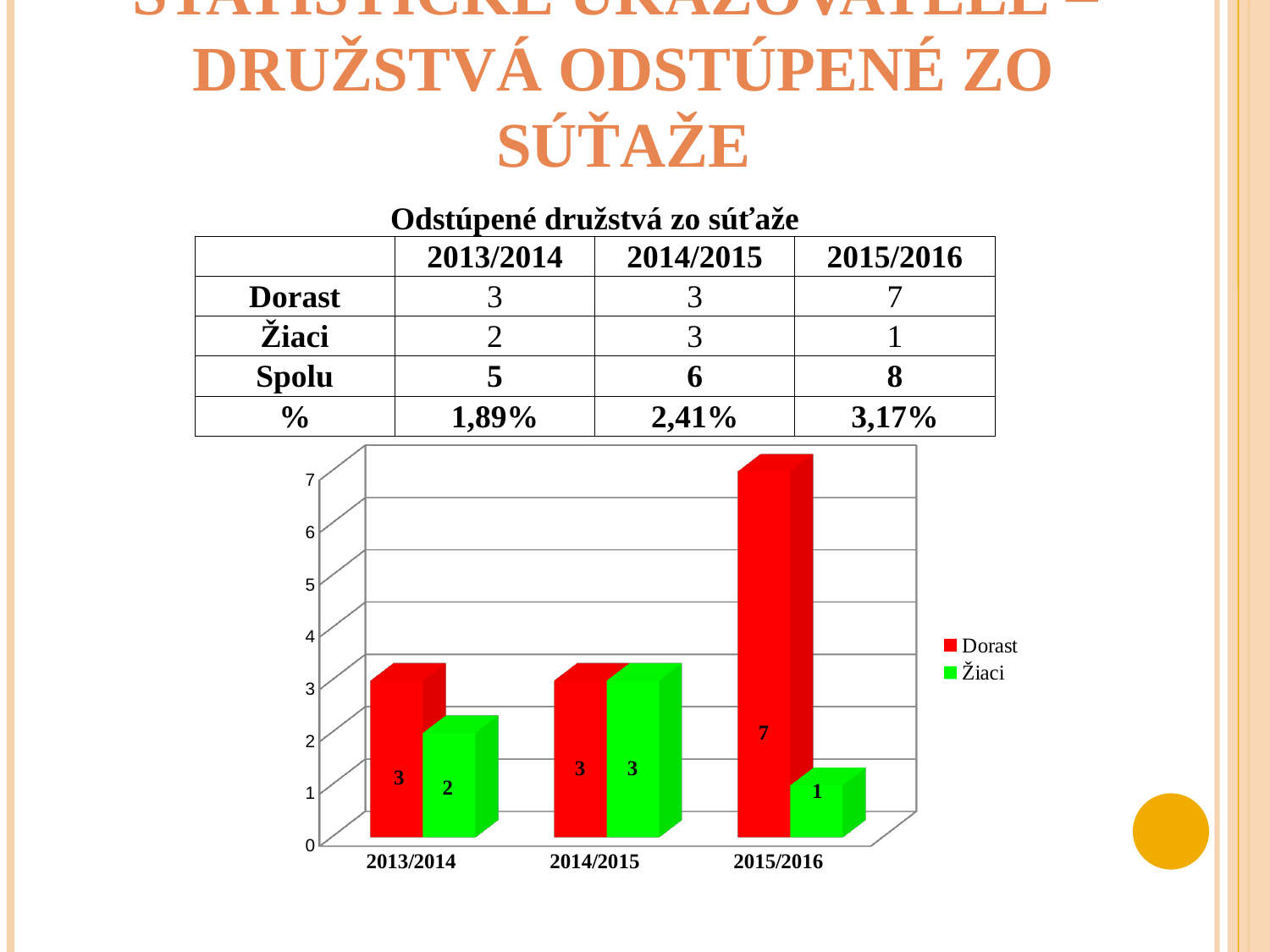
What is the value for Žiaci in 2013/2014? 2 What kind of chart is shown on the slide? bar chart In which season is the Žiaci value lowest? 2015/2016 What is the value for Dorast in 2015/2016? 7 In which season is the Dorast value highest? 2015/2016 How many series does the chart legend list? 2 Does the Dorast value rise or fall from 2014/2015 to 2015/2016? rise What is the value for Žiaci in 2014/2015? 3 Which is larger in 2013/2014, Dorast or Žiaci? Dorast How many seasons are shown on the x axis of the chart? 3 Which colour represents the Žiaci series in the chart? green What is the difference between the Dorast and Žiaci values in 2015/2016? 6